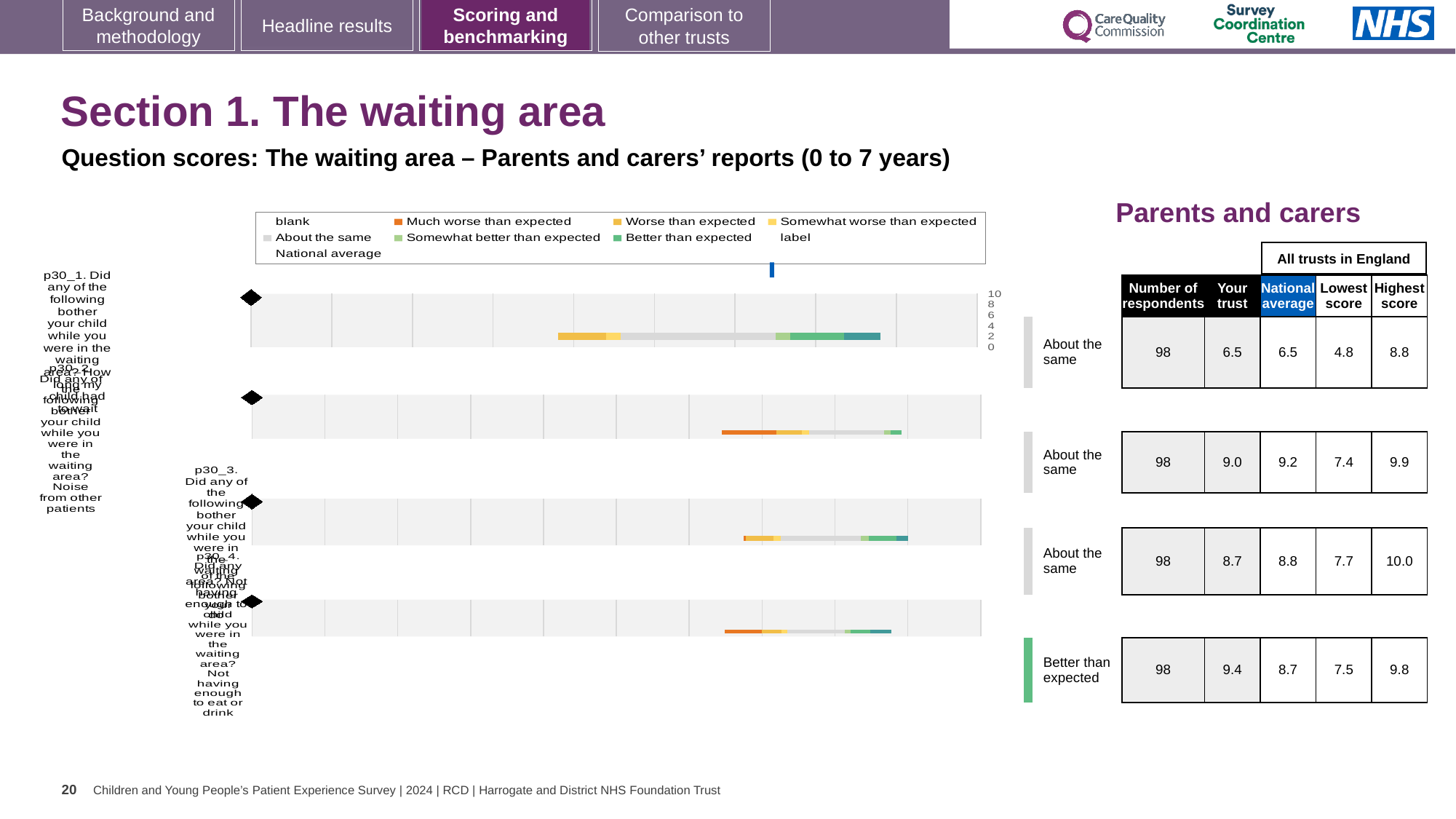
Which legend entry is shown in orange? Much worse than expected In the table, what is the national average for the second question (p30_2)? 9.2 In the table, what is the highest score for the third question (p30_3)? 10.0 What kind of chart is shown on the slide? bar chart What is the highest value shown on the chart's axis? 10 For the fourth question (p30_4), how much higher is the 'Your trust' score than the national average? 0.7 In the table, what is the lowest score for the fourth question (p30_4, not having enough to eat or drink)? 7.5 Which question is rated 'Better than expected' rather than 'About the same'? p30_4 (Not having enough to eat or drink) In the table, how many respondents are listed for the first question (p30_1)? 98 In the table, what is the 'Your trust' score for the second question (p30_2, noise from other patients)? 9.0 How many entries does the chart legend list? 9 How many question bars are plotted in the chart? 4